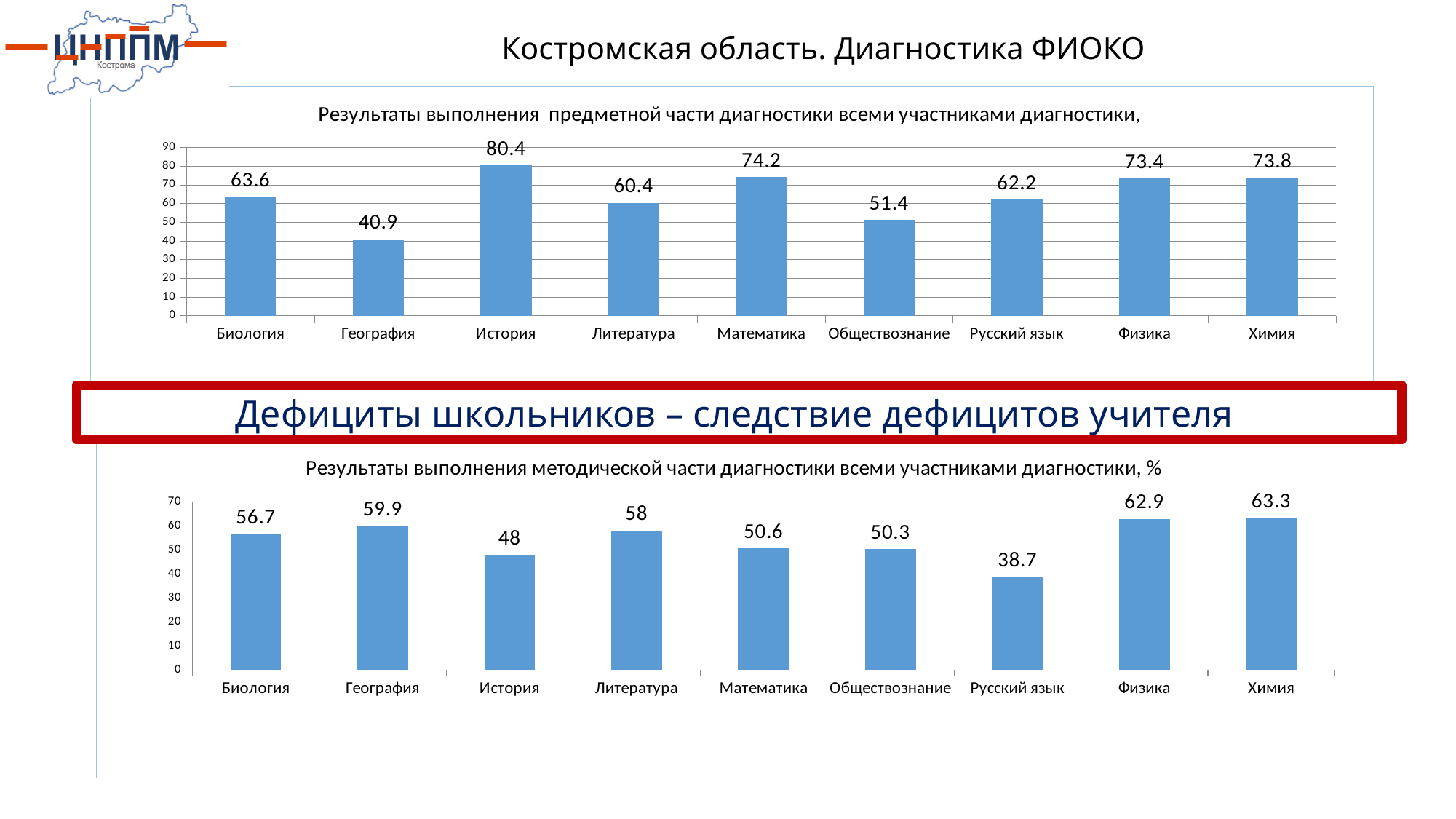
What type of chart is the bottom chart (методической части)? Bar chart In the bottom chart (методической части), what is the value for Литература? 58 In the top chart (предметной части), how many subjects are shown? 9 In the bottom chart (методической части), which is larger: the value for Биология or the value for История? Биология In the top chart (предметной части), what is the difference between the values for История and География? 39.5 In the bottom chart (методической части), which subject has the highest value? Химия In the bottom chart (методической части), what is the difference between the values for Физика and Математика? 12.3 In the bottom chart (методической части), what is the value for Русский язык? 38.7 In the top chart (предметной части), what is the value for История? 80.4 What is the text in the red-bordered box between the two charts? Дефициты школьников – следствие дефицитов учителя In the top chart (предметной части), which subject has the lowest value? География In the top chart (предметной части), is the value for Обществознание greater or less than 60? less